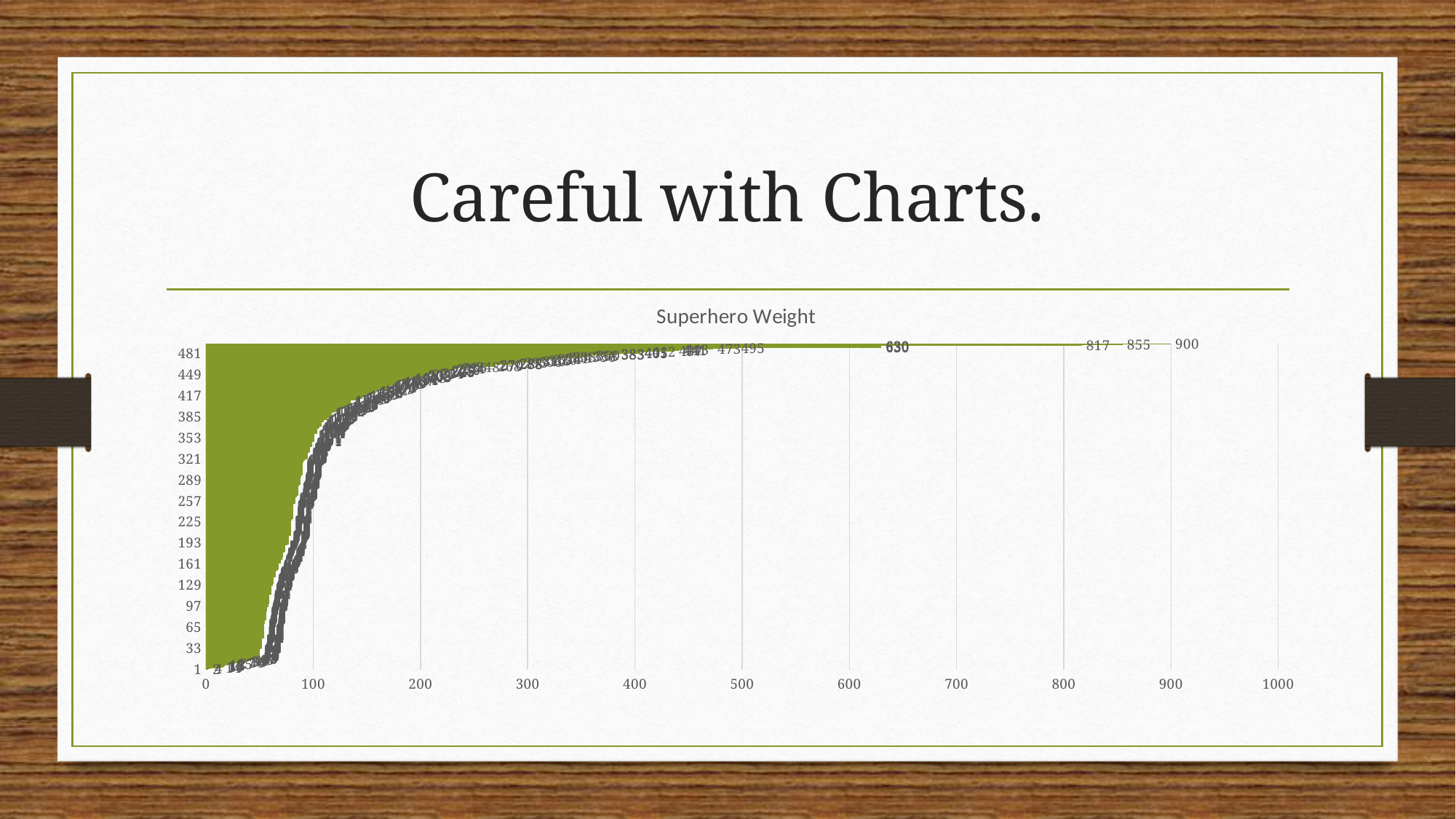
What is the difference between the labeled values 855 and 817? 38 What is the title of the chart? Superhero Weight What is the largest value labeled on the chart? 900 What kind of chart is shown on the slide? bar chart Is the longest bar in the chart greater or less than 800? greater Do the bar lengths generally increase or decrease moving from the bottom of the chart to the top? increase Which labeled value is larger, 630 or 495? 630 What is the highest tick value shown on the horizontal axis? 1000 What is the difference between the two largest labeled values, 900 and 855? 45 Is the bar labeled 473 greater or less than 500? less Is the bar labeled 630 greater or less than 600? greater What is the highest category label shown on the vertical axis? 481